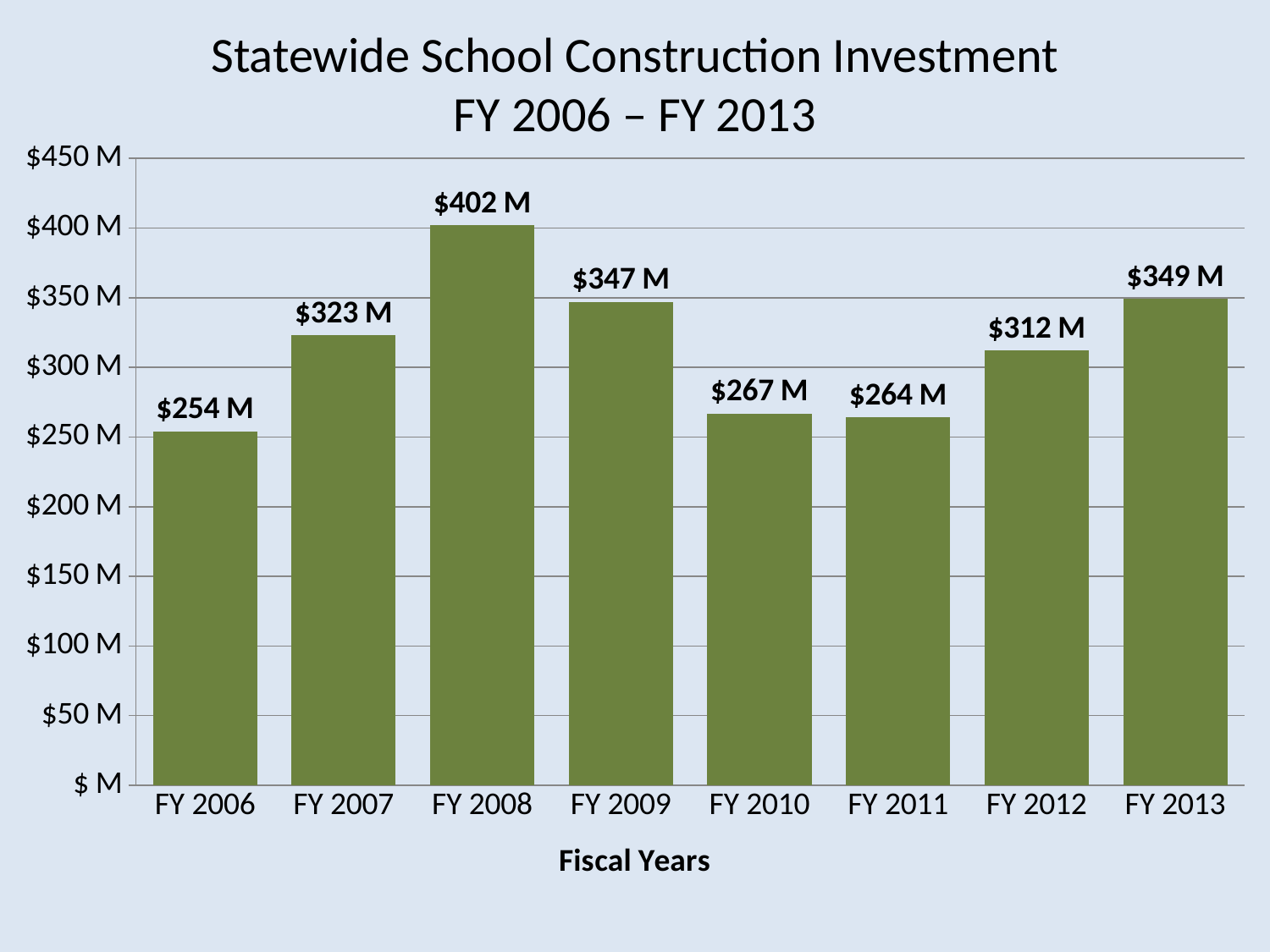
What is the investment value shown for FY 2011? $264 M What is the investment value shown for FY 2013? $349 M How much higher is the FY 2013 investment than the FY 2012 investment? $37 M Which is larger, the investment in FY 2007 or in FY 2009? FY 2009 What is the difference between the investment in FY 2008 and FY 2006? $148 M How many fiscal years are shown on the chart? 8 What is the label of the x axis? Fiscal Years Which fiscal year has the lowest school construction investment? FY 2006 What kind of chart is shown on the slide? Bar chart Is the value for FY 2010 greater or less than $300 M? less What is the statewide school construction investment for FY 2008? $402 M Which fiscal year has the highest school construction investment? FY 2008